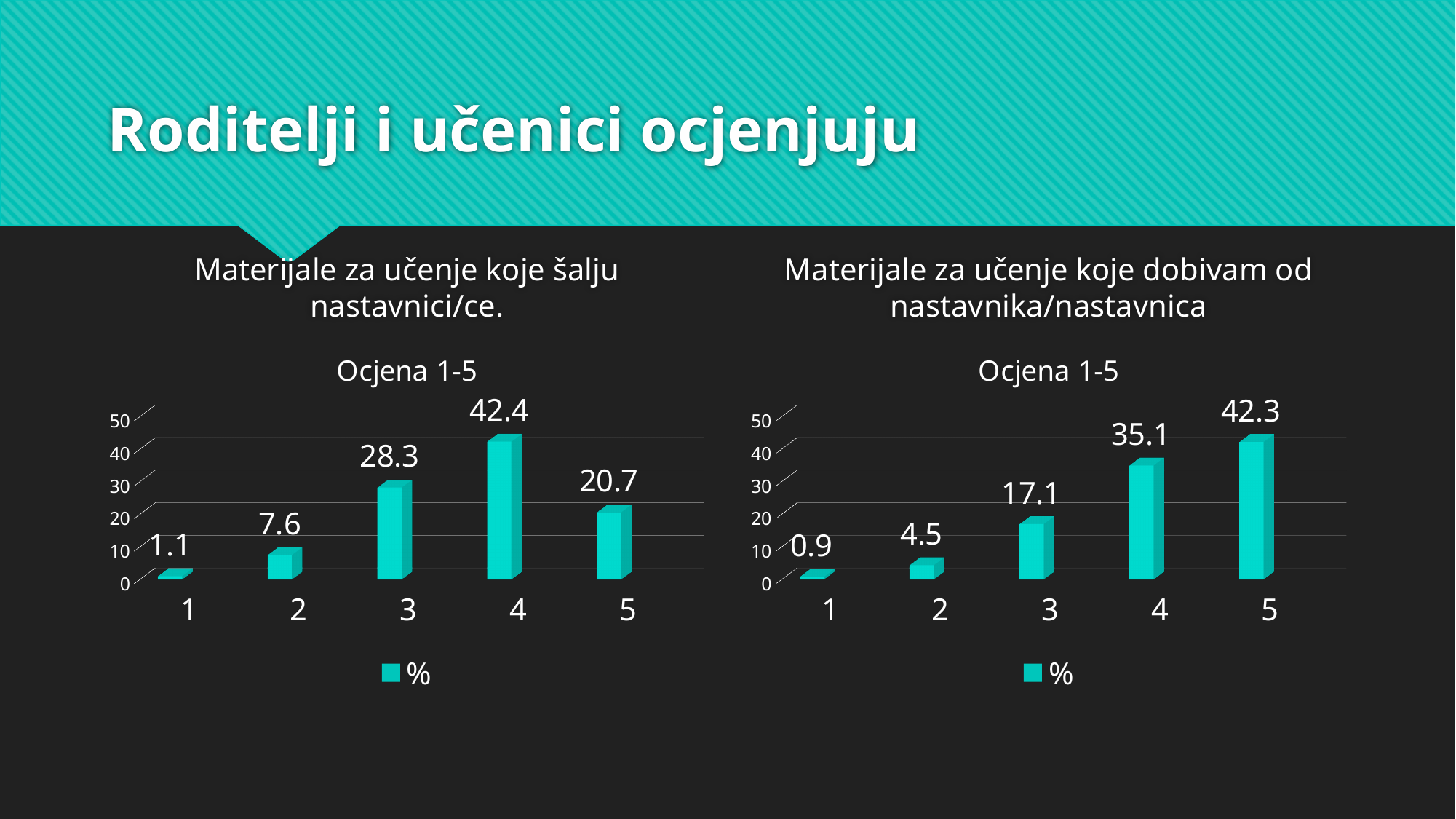
In the right chart, what is the difference between the values for category 5 and category 4? 7.2 In the left chart, what is the difference between the values for category 4 and category 5? 21.7 In the right chart, which category has the highest value? 5 In the left chart, which category has the highest value? 4 In the left chart (Materijale za učenje koje šalju nastavnici/ce.), what is the value for category 4? 42.4 Do the values in the right chart rise or fall from category 1 to category 5? rise What kind of chart is the left chart? bar chart In the right chart, which category has the lowest value? 1 How many categories are shown on the x axis of the right chart? 5 In the left chart, which is larger: the value for category 3 or the value for category 5? 3 In the right chart (Materijale za učenje koje dobivam od nastavnika/nastavnica), what is the value for category 3? 17.1 How many series does the legend of the left chart list? 1